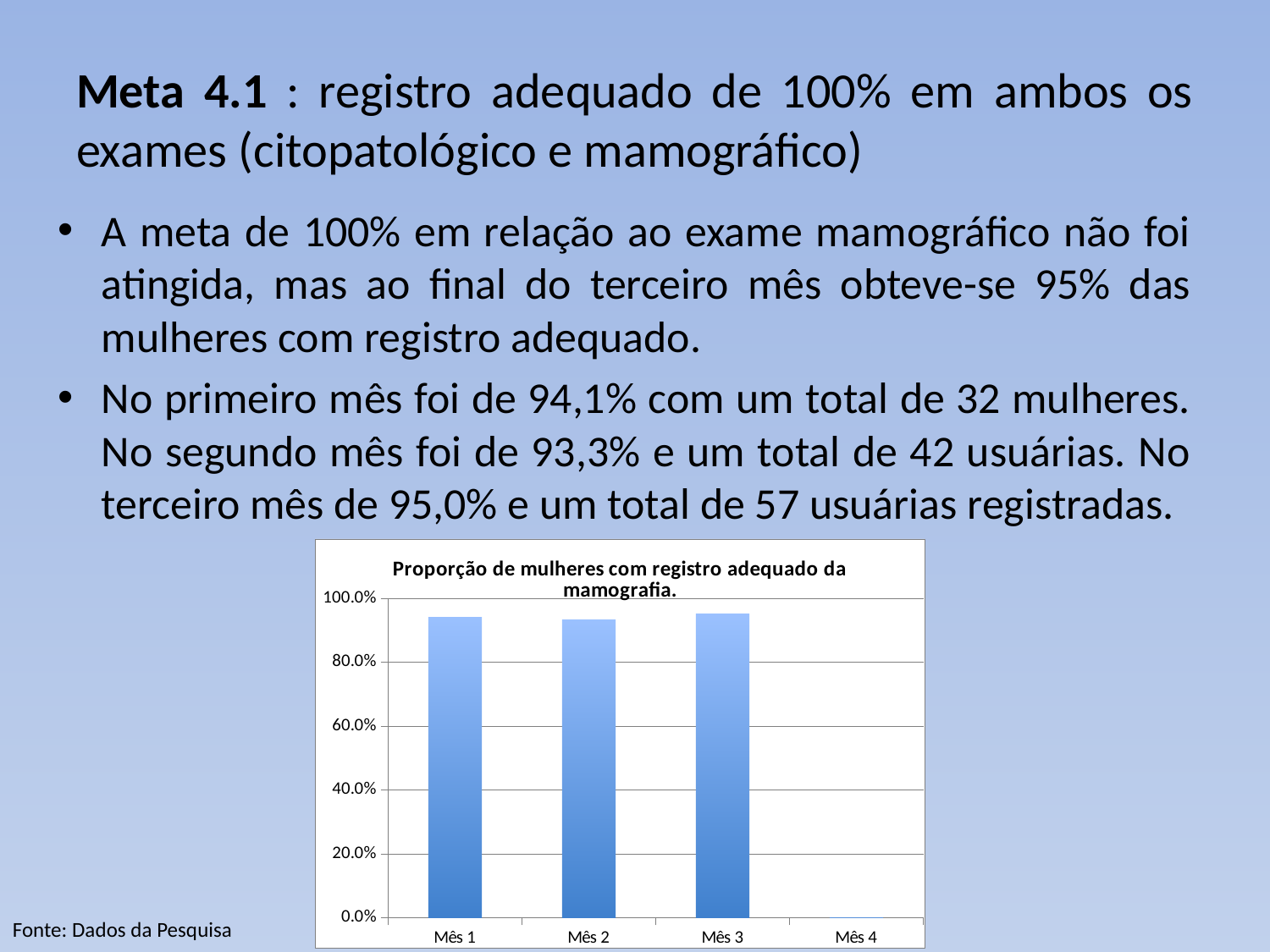
Is the value for Mês 2 greater or less than 80.0%? greater What is the highest tick label shown on the y axis of the chart? 100.0% Is the value for Mês 4 greater or less than 20.0%? less Is the value for Mês 3 greater or less than 100.0%? less Which is larger, the value for Mês 1 or the value for Mês 4? Mês 1 What kind of chart is shown on the slide? bar chart Which category has the lowest value in the chart? Mês 4 Which is larger, the value for Mês 2 or the value for Mês 4? Mês 2 What is the title of the chart? Proporção de mulheres com registro adequado da mamografia. How many categories are shown on the x axis of the chart? 4